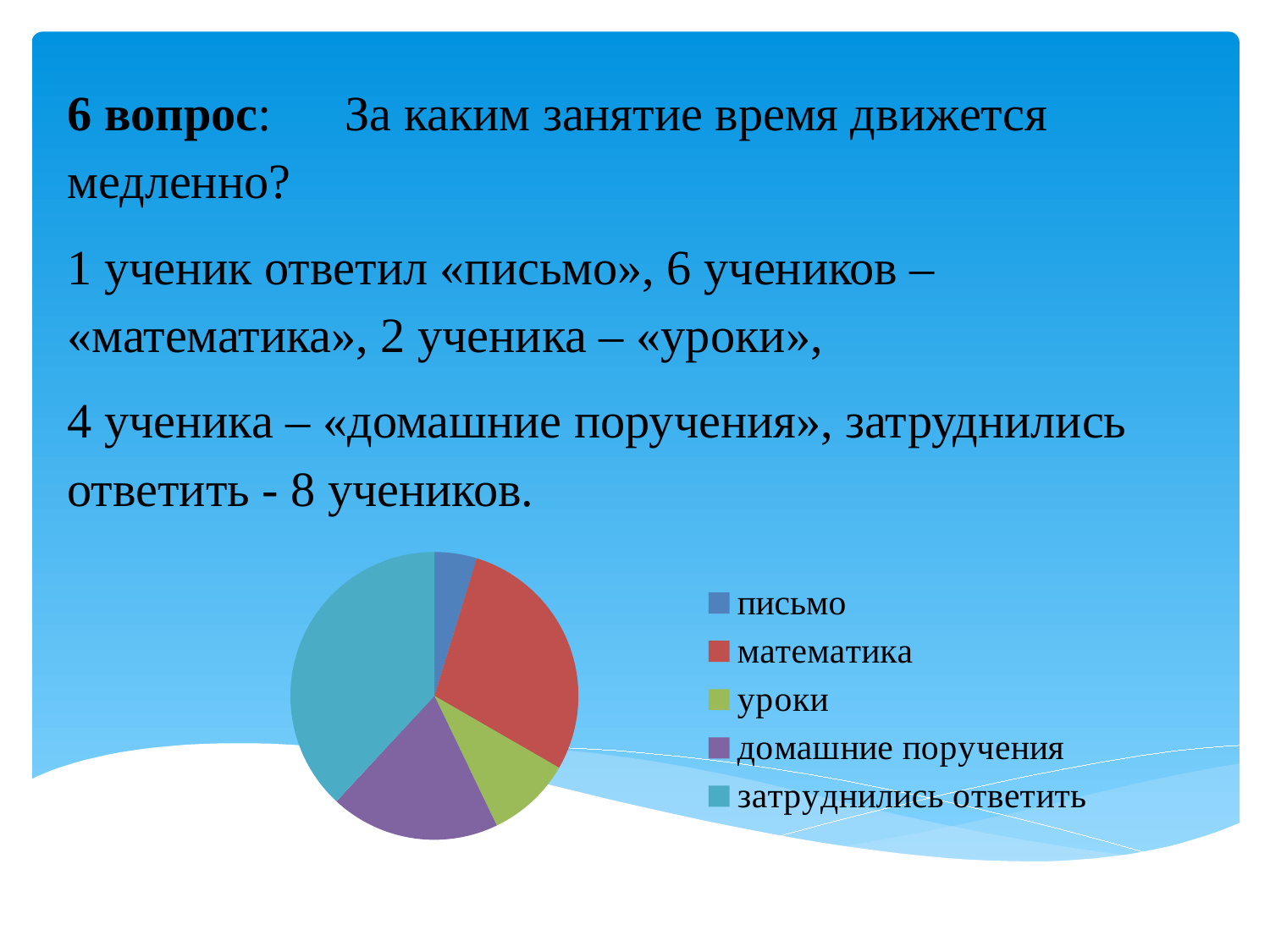
According to the slide, how many students answered «домашние поручения»? 4 How many more students chose «затруднились ответить» than «математика»? 2 Which slice is larger in the pie chart: «уроки» or «письмо»? уроки How many entries does the legend of the pie chart list? 5 What kind of chart is shown on the slide? pie chart Which category has the smallest slice in the pie chart? письмо What colour is the «затруднились ответить» slice in the pie chart? teal According to the slide, how many students answered «математика»? 6 How many slices does the pie chart have? 5 Which slice is larger in the pie chart: «математика» or «домашние поручения»? математика Which category has the largest slice in the pie chart? затруднились ответить According to the slide, how many students answered «уроки»? 2